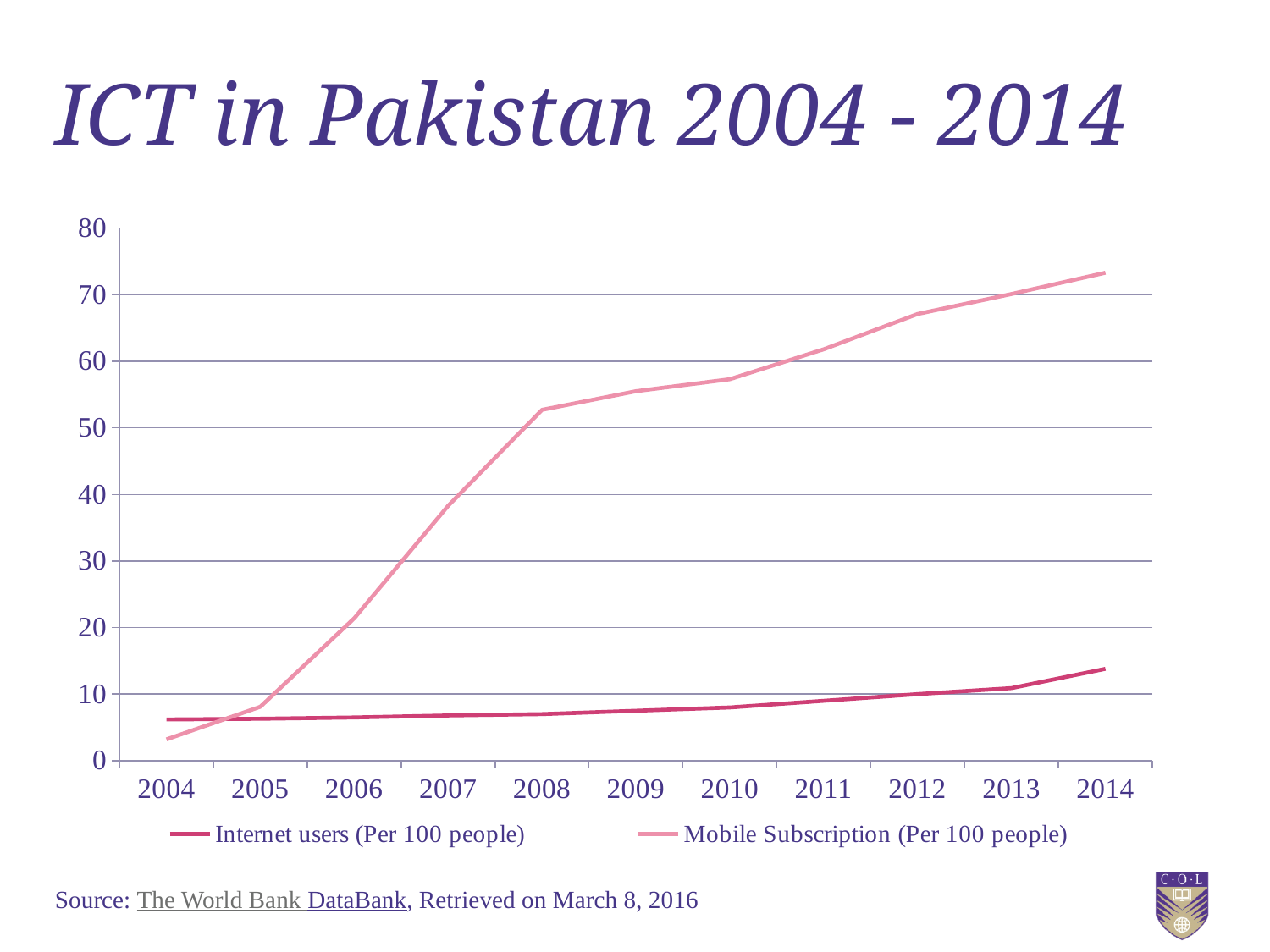
Does the Mobile Subscription (Per 100 people) series rise or fall from 2004 to 2014? rise In 2004, which series has the larger value, Internet users or Mobile Subscription? Internet users (Per 100 people) In 2014, which series has the larger value, Internet users or Mobile Subscription? Mobile Subscription (Per 100 people) What is the title of the chart slide? ICT in Pakistan 2004 - 2014 Which series is drawn in the lighter pink line? Mobile Subscription (Per 100 people) In which year is Mobile Subscription (Per 100 people) lowest? 2004 How many series does the legend list? 2 Is the value for Mobile Subscription (Per 100 people) in 2014 greater or less than 70? greater Is the value for Internet users (Per 100 people) in 2010 greater or less than 10? less What kind of chart is shown on the slide? line chart How many years are plotted along the x axis? 11 In which year is Mobile Subscription (Per 100 people) highest? 2014